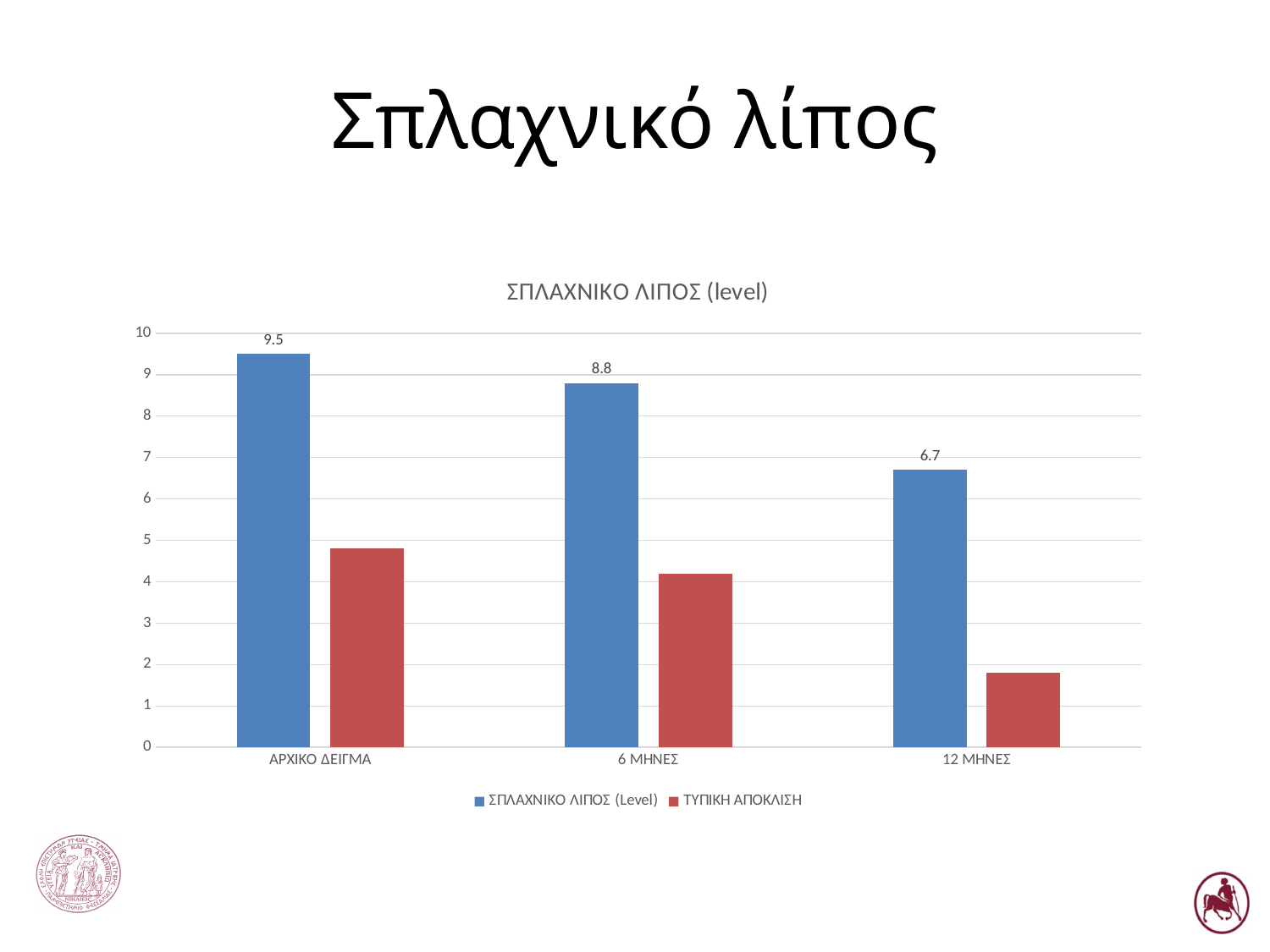
Which is larger: the ΣΠΛΑΧΝΙΚΟ ΛΙΠΟΣ (Level) value at 6 ΜΗΝΕΣ or at 12 ΜΗΝΕΣ? 6 ΜΗΝΕΣ What is the difference between the ΣΠΛΑΧΝΙΚΟ ΛΙΠΟΣ (Level) values for ΑΡΧΙΚΟ ΔΕΙΓΜΑ and 12 ΜΗΝΕΣ? 2.8 How many categories are shown on the x axis? 3 Which category has the highest ΣΠΛΑΧΝΙΚΟ ΛΙΠΟΣ (Level) value? ΑΡΧΙΚΟ ΔΕΙΓΜΑ What is the value of ΣΠΛΑΧΝΙΚΟ ΛΙΠΟΣ (Level) at 6 ΜΗΝΕΣ? 8.8 Which category has the lowest ΣΠΛΑΧΝΙΚΟ ΛΙΠΟΣ (Level) value? 12 ΜΗΝΕΣ Does the ΣΠΛΑΧΝΙΚΟ ΛΙΠΟΣ (Level) value rise or fall from ΑΡΧΙΚΟ ΔΕΙΓΜΑ to 12 ΜΗΝΕΣ? fall Is the ΤΥΠΙΚΗ ΑΠΟΚΛΙΣΗ value for ΑΡΧΙΚΟ ΔΕΙΓΜΑ greater or less than 4? greater How many series does the legend list? 2 Is the ΤΥΠΙΚΗ ΑΠΟΚΛΙΣΗ value for 12 ΜΗΝΕΣ greater or less than 2? less What is the value of ΣΠΛΑΧΝΙΚΟ ΛΙΠΟΣ (Level) for ΑΡΧΙΚΟ ΔΕΙΓΜΑ? 9.5 What is the value of ΣΠΛΑΧΝΙΚΟ ΛΙΠΟΣ (Level) at 12 ΜΗΝΕΣ? 6.7